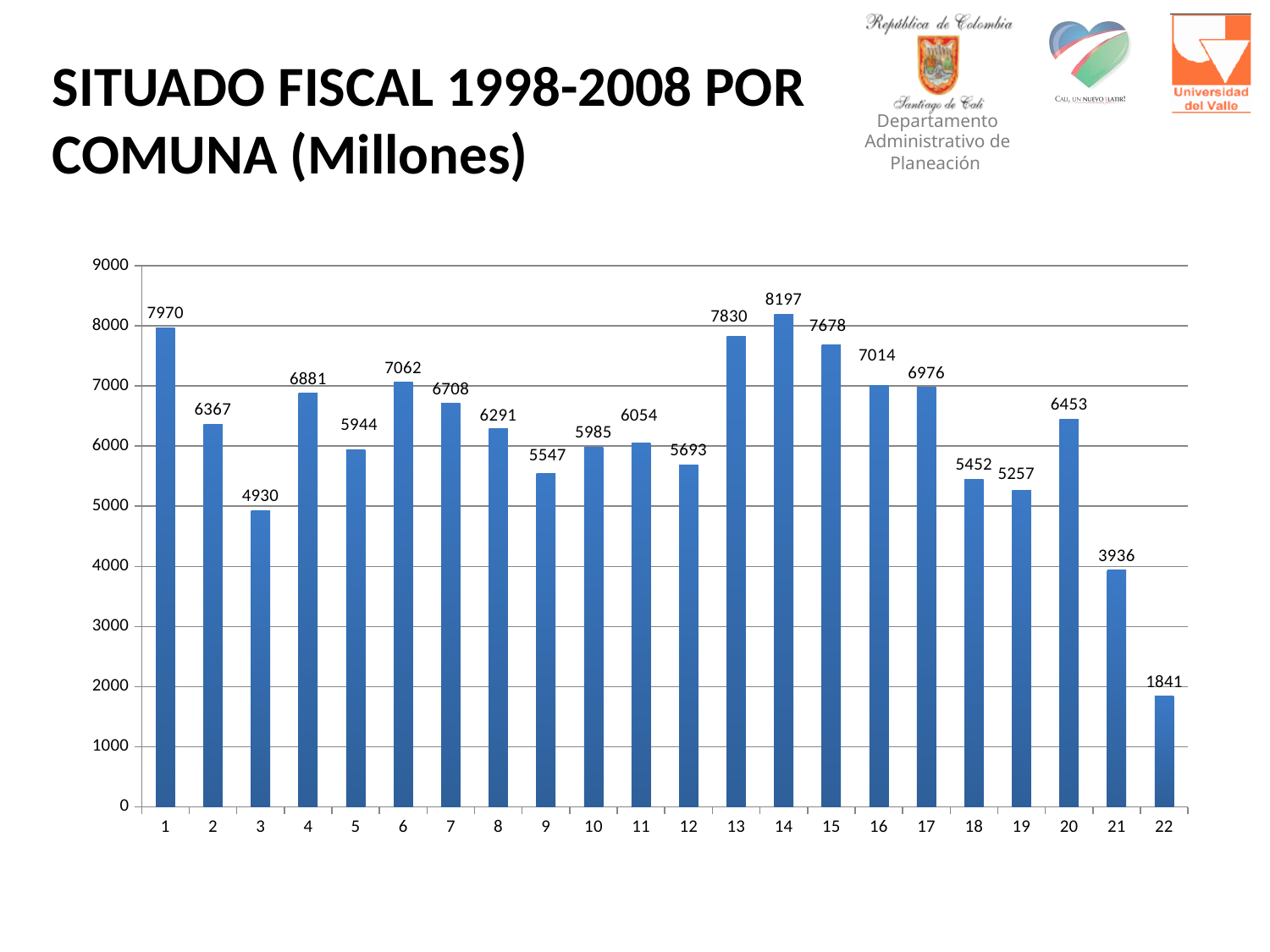
What is the difference between the values for comuna 21 and comuna 22? 2095 Which comuna has the highest value? 14 Which has a larger value, comuna 9 or comuna 12? 12 Which has a larger value, comuna 13 or comuna 15? 13 What is the value for comuna 3? 4930 What is the difference between the values for comuna 1 and comuna 2? 1603 How many comunas are shown on the chart? 22 What kind of chart is shown on the slide? bar chart What is the value for comuna 20? 6453 Which comuna has the lowest value? 22 What is the value for comuna 14? 8197 Is the value for comuna 18 greater or less than 6000? less